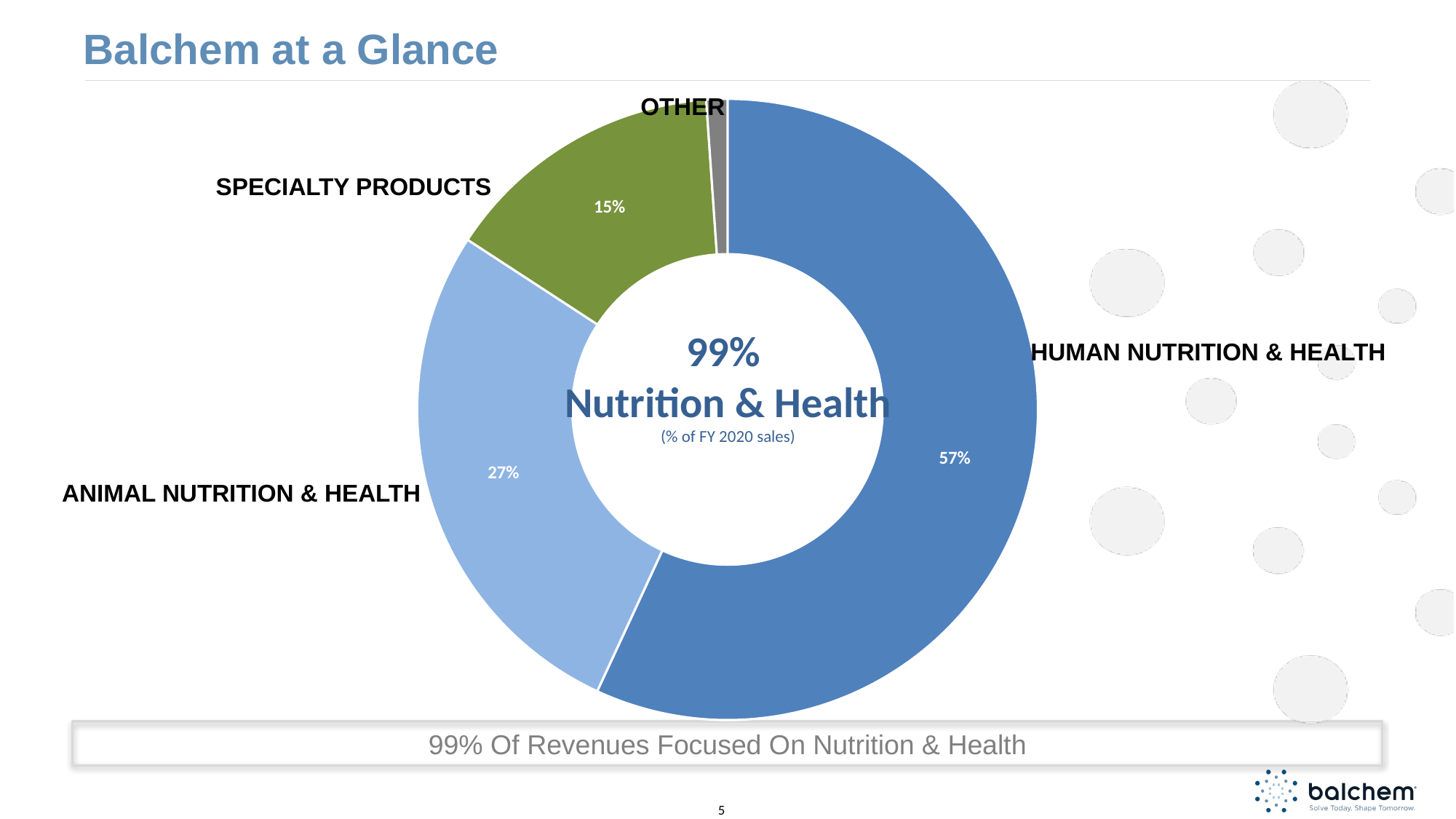
How many percentage points larger is Human Nutrition & Health than Animal Nutrition & Health? 30 What is the difference in percentage points between Animal Nutrition & Health and Specialty Products? 12 What kind of chart is shown on the slide? Pie chart (donut) What combined share of sales do Human Nutrition & Health and Animal Nutrition & Health represent? 84% Which segment has the smallest share of FY 2020 sales? Other What share of FY 2020 sales does Human Nutrition & Health account for? 57% How many segments does the chart show? 4 Which segment has the largest share of FY 2020 sales? Human Nutrition & Health What percentage of sales is shown for Specialty Products? 15% Which is larger, the share for Specialty Products or the share for Animal Nutrition & Health? Animal Nutrition & Health What percentage is printed in the centre of the chart for Nutrition & Health? 99% What percentage of sales is shown for Animal Nutrition & Health? 27%